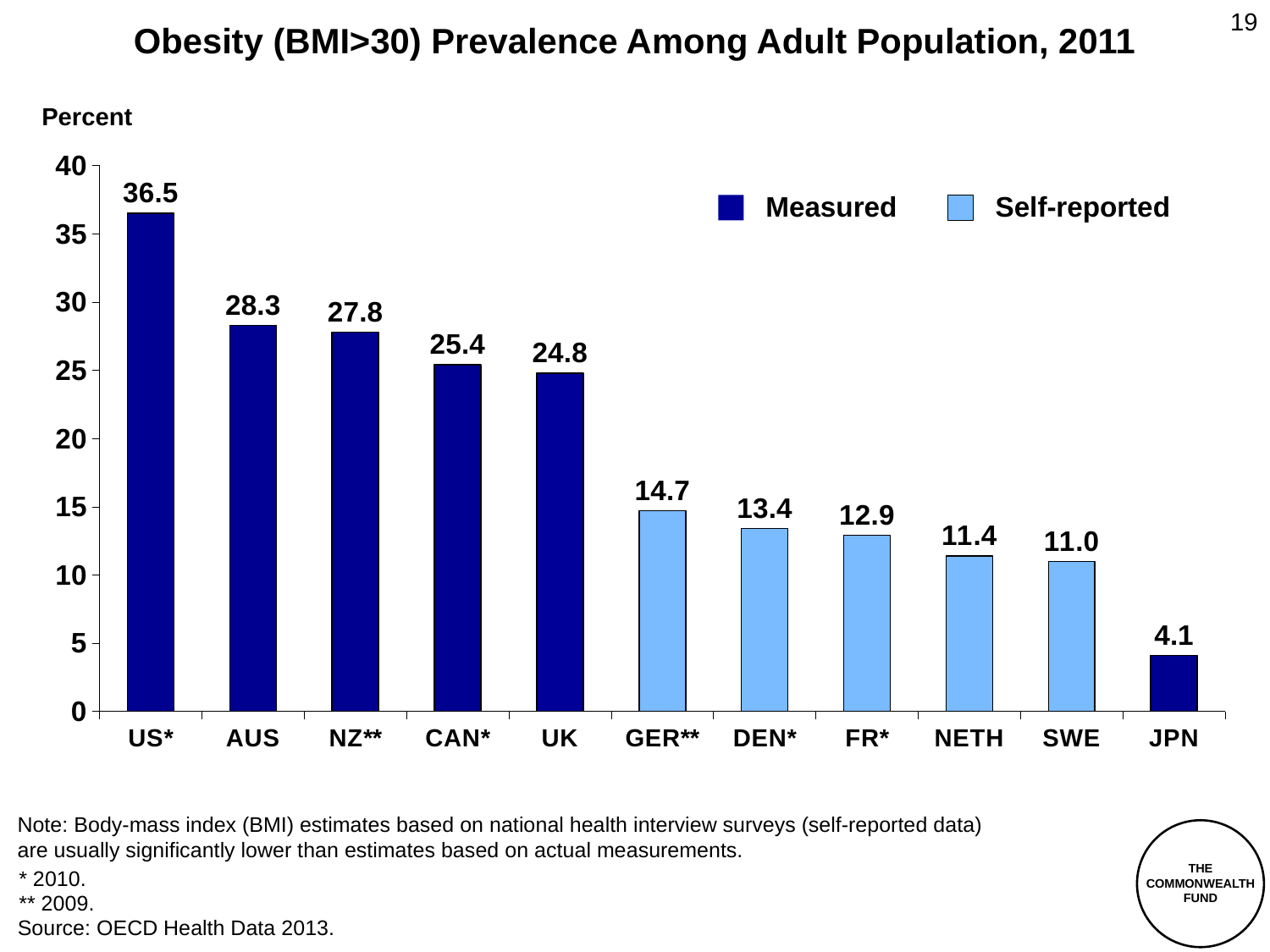
Is the value for NETH greater or less than 10? greater What is the obesity prevalence value shown for US*? 36.5 What is the value shown for JPN? 4.1 What kind of chart is shown on the slide? Bar chart Which country has the lowest obesity prevalence on the chart? JPN Which legend entry is shown in light blue? Self-reported Which country has the highest obesity prevalence on the chart? US* What is the value shown for GER**? 14.7 Which has a larger value, CAN* or UK? CAN* What is the difference between the values for US* and AUS? 8.2 How many countries are shown on the chart? 11 How many series does the legend list? 2